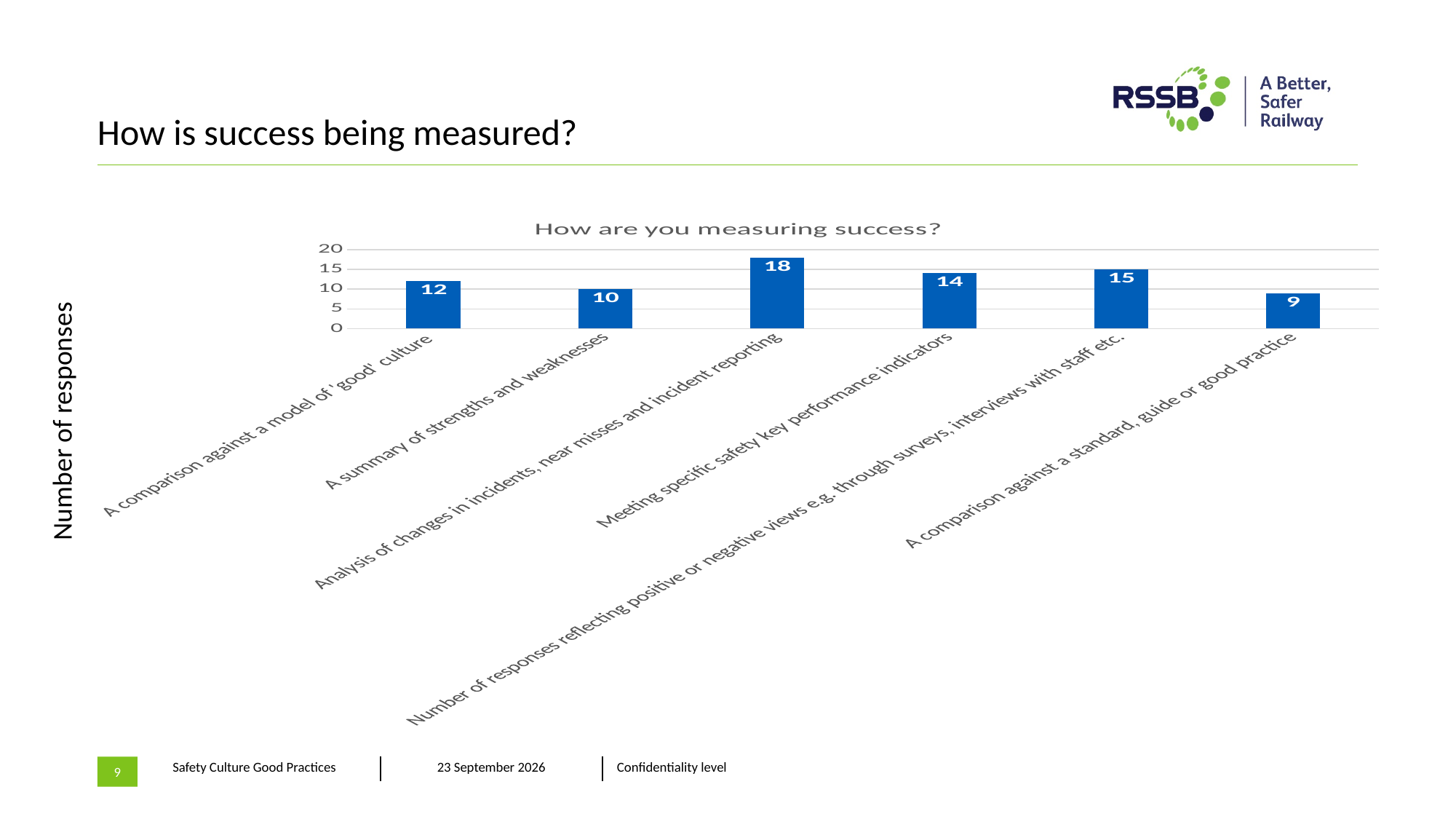
What is the label on the vertical axis of the chart? Number of responses Which is larger: the value for 'Number of responses reflecting positive or negative views e.g. through surveys, interviews with staff etc.' or the value for 'Meeting specific safety key performance indicators'? Number of responses reflecting positive or negative views e.g. through surveys, interviews with staff etc. What is the difference between the values for 'Analysis of changes in incidents, near misses and incident reporting' and 'A summary of strengths and weaknesses'? 8 What is the value for 'A comparison against a model of 'good' culture'? 12 Which category has the lowest number of responses? A comparison against a standard, guide or good practice What is the value for 'Meeting specific safety key performance indicators'? 14 What is the title of the chart? How are you measuring success? What is the value for 'A comparison against a standard, guide or good practice'? 9 How many categories are shown in the chart? 6 What kind of chart is shown on the slide? bar chart Is the value for 'A summary of strengths and weaknesses' greater or less than 15? less Which category has the highest number of responses? Analysis of changes in incidents, near misses and incident reporting